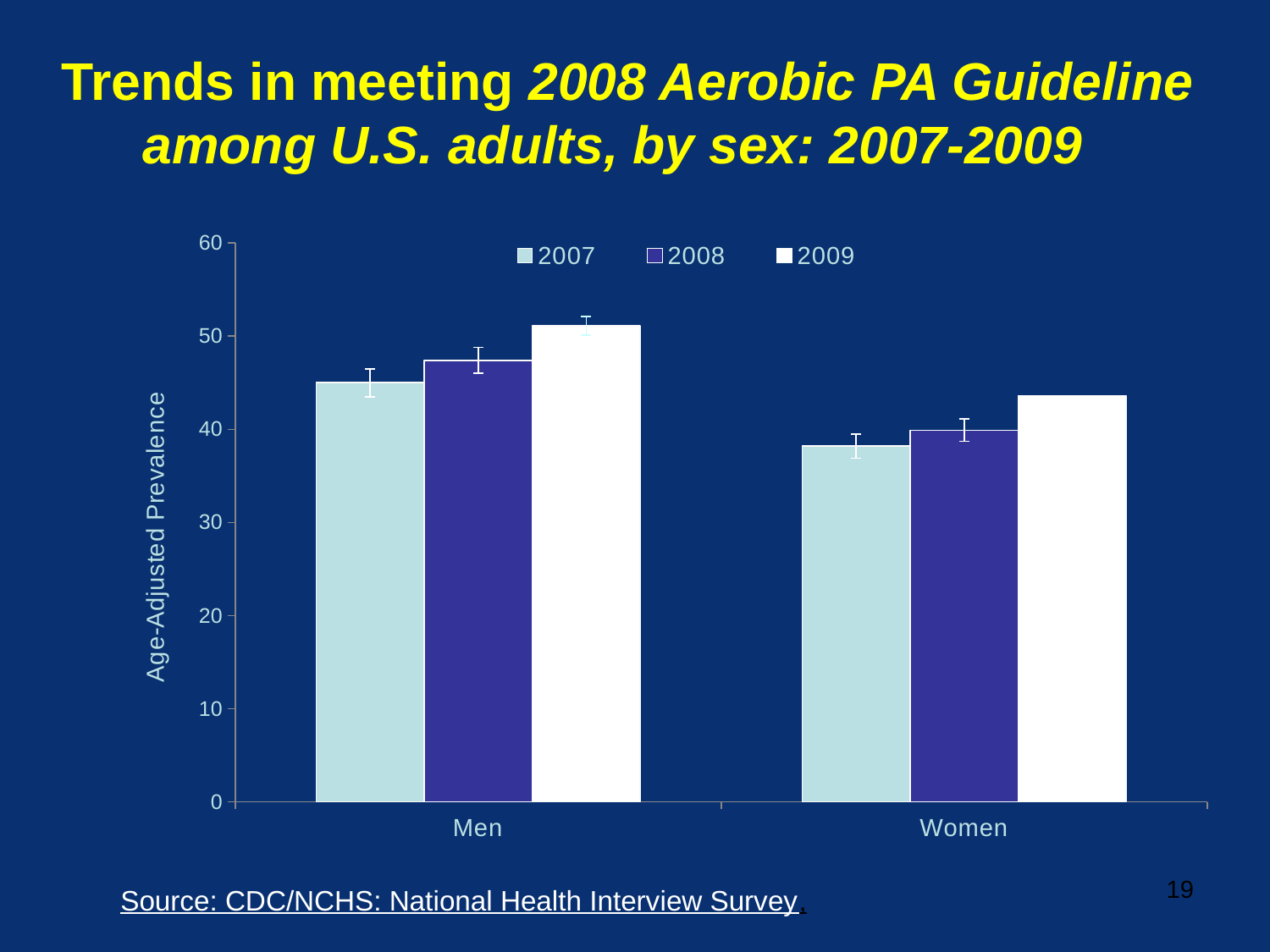
Is the value for Women in 2007 greater or less than 40? less How many series does the legend list? 3 For Men, do the values rise or fall from 2007 to 2009? rise Is the value for Women in 2009 greater or less than 40? greater Is the value for Men in 2007 greater or less than 40? greater What kind of chart is shown on the slide? bar chart What is the label on the y axis? Age-Adjusted Prevalence Which category and year has the highest bar? Men, 2009 Which is larger, the 2009 value for Men or the 2009 value for Women? Men How many categories are shown on the x axis? 2 Which category and year has the lowest bar? Women, 2007